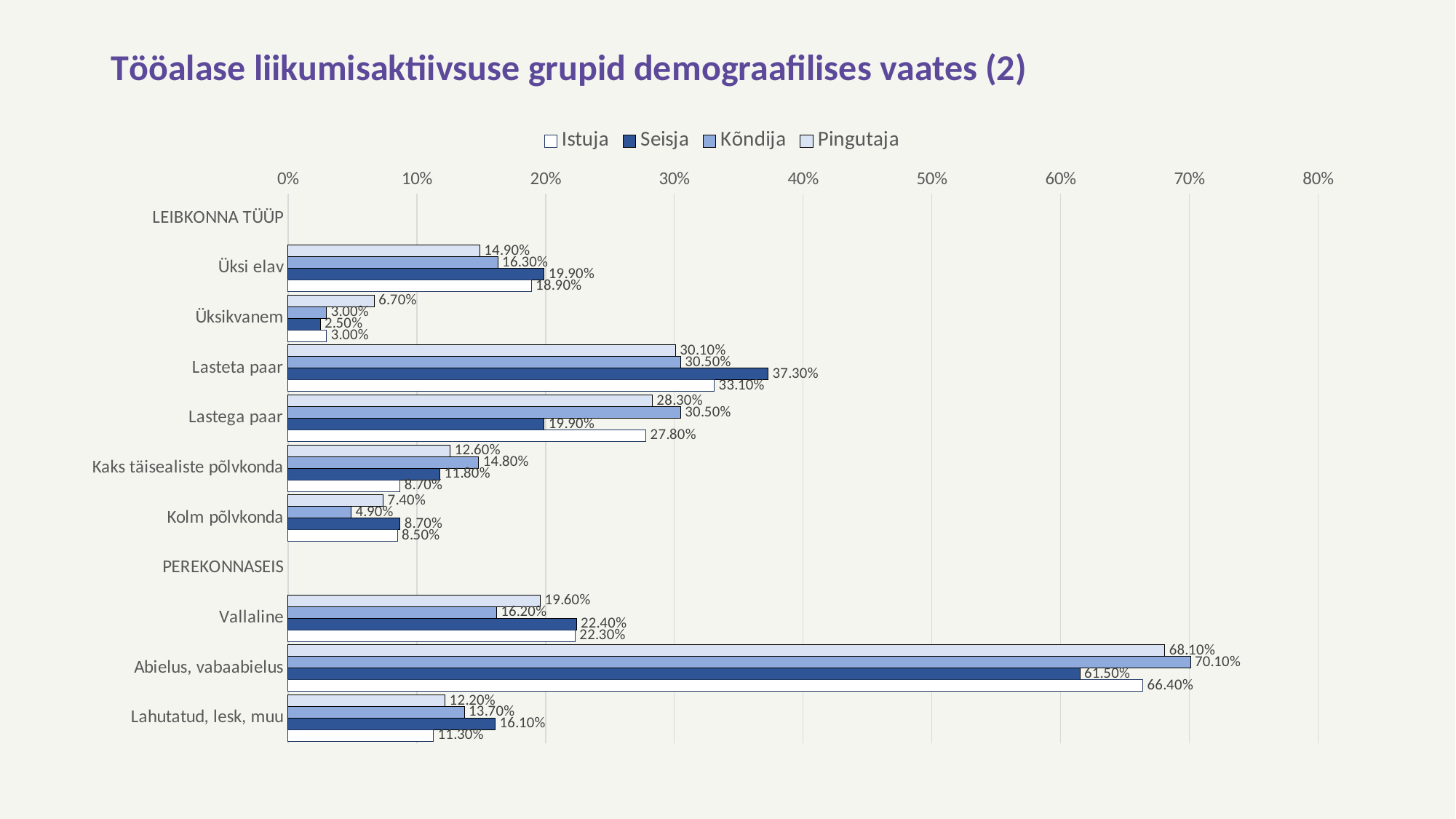
How many series does the legend list? 4 Which category has the lowest value for Seisja? Üksikvanem What is the value for Istuja in the Lahutatud, lesk, muu category? 11.30% Which is larger in the Üksi elav category: the Seisja value or the Istuja value? Seisja Which category has the highest value for Istuja? Abielus, vabaabielus What is the title of the chart? Tööalase liikumisaktiivsuse grupid demograafilises vaates (2) What kind of chart is shown on the slide? Bar chart What is the value for Pingutaja in the Üksikvanem category? 6.70% Is the value for Pingutaja in the Abielus, vabaabielus category greater or less than 60%? greater What is the value for Kõndija in the Abielus, vabaabielus category? 70.10% What is the difference between the Kõndija and Seisja values in the Lastega paar category? 10.60% What is the value for Seisja in the Lasteta paar category? 37.30%